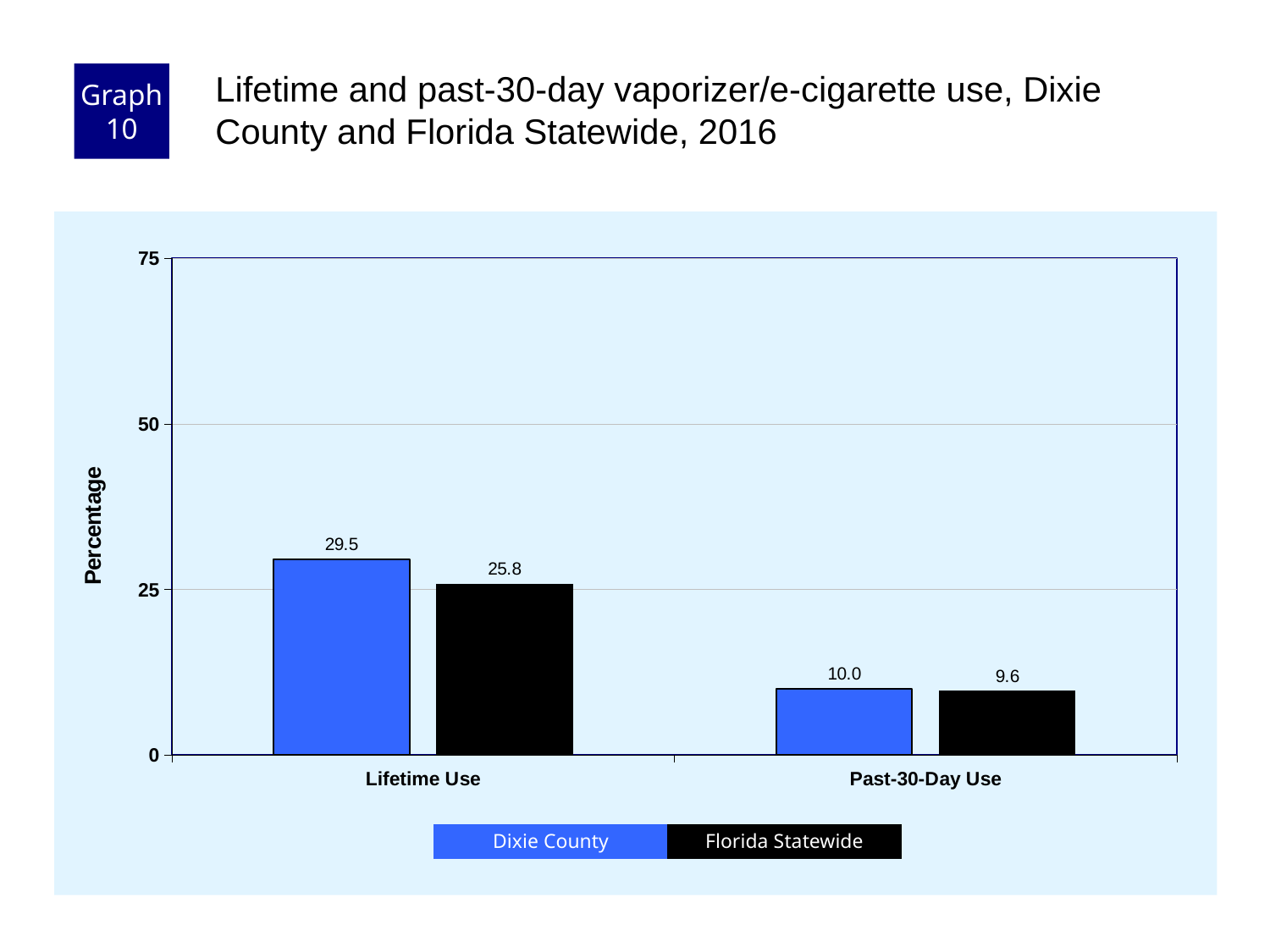
What is the Florida Statewide value for Lifetime Use? 25.8 What is the difference between the Dixie County and Florida Statewide values for Lifetime Use? 3.7 What is the Florida Statewide value for Past-30-Day Use? 9.6 Is the Dixie County value for Lifetime Use greater or less than 25? greater What is the Dixie County value for Past-30-Day Use? 10.0 Which bar has the lowest value on the chart? Florida Statewide, Past-30-Day Use How many categories are shown on the x axis? 2 How many series does the legend list? 2 Which bar has the highest value on the chart? Dixie County, Lifetime Use For Past-30-Day Use, which is larger: Dixie County or Florida Statewide? Dixie County What kind of chart is shown on the slide? Bar chart What is the Dixie County value for Lifetime Use? 29.5